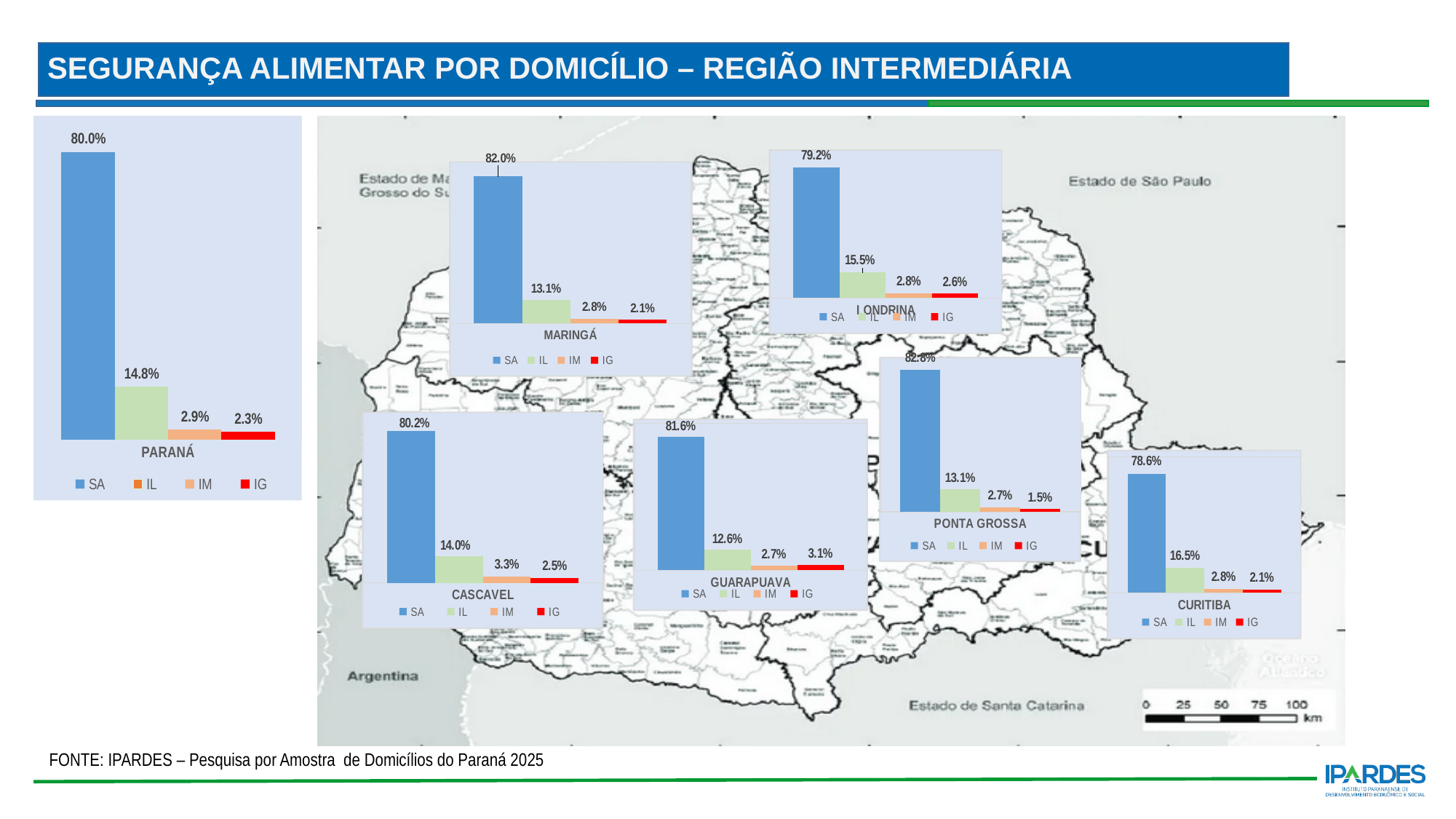
How many series does the legend of the LONDRINA chart list? 4 In the GUARAPUAVA chart, what is the total of the IM and IG values? 5.8% In the LONDRINA chart, what is the value for IG? 2.6% In the PONTA GROSSA chart, which category has the highest value? SA In the CURITIBA chart, what is the difference between the SA value and the IL value? 62.1% In the MARINGÁ chart, what is the value for IL? 13.1% In the GUARAPUAVA chart, which category has the lowest value? IM In the PARANÁ chart, what is the value for SA? 80.0% What is the title of the slide? SEGURANÇA ALIMENTAR POR DOMICÍLIO – REGIÃO INTERMEDIÁRIA In the PARANÁ chart, which is larger, the IM value or the IG value? IM What kind of chart is the CASCAVEL chart? Bar chart In the CASCAVEL chart, what is the value for IM? 3.3%